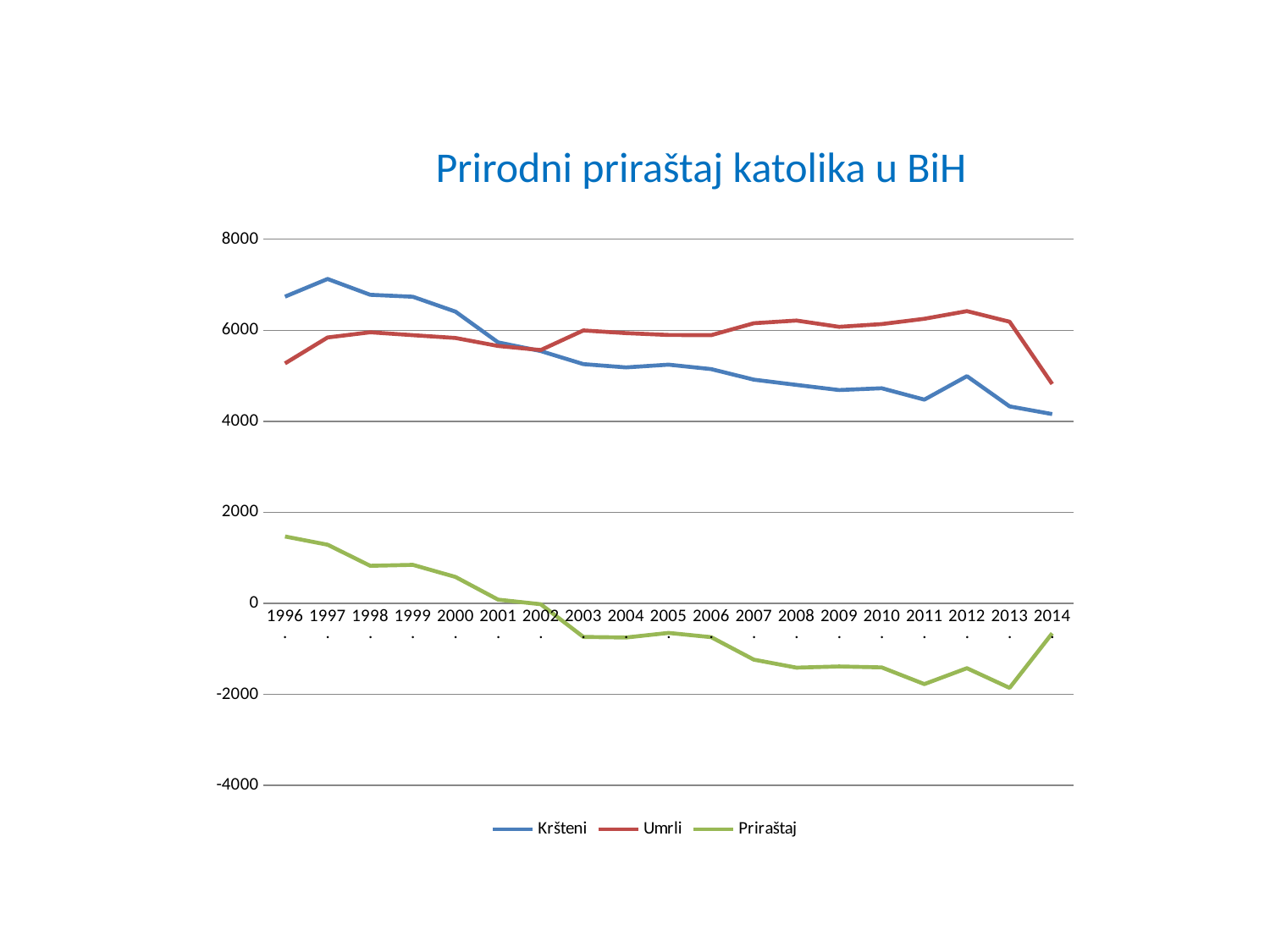
Which series is drawn in green? Priraštaj How many years are plotted along the x axis? 19 What is the title of the chart? Prirodni priraštaj katolika u BiH What kind of chart is shown on the slide? line chart In which year is the Kršteni series at its highest? 1997 How many series does the legend list? 3 In which year is the Umrli series at its lowest? 2014 In 1996, which is larger, Kršteni or Umrli? Kršteni Is the value of Kršteni in 1997 greater or less than 6000? greater Does the Kršteni series generally rise or fall from 1996 to 2014? fall In which year is the Priraštaj series at its highest? 1996 Is the value of Priraštaj in 2013 greater or less than 0? less